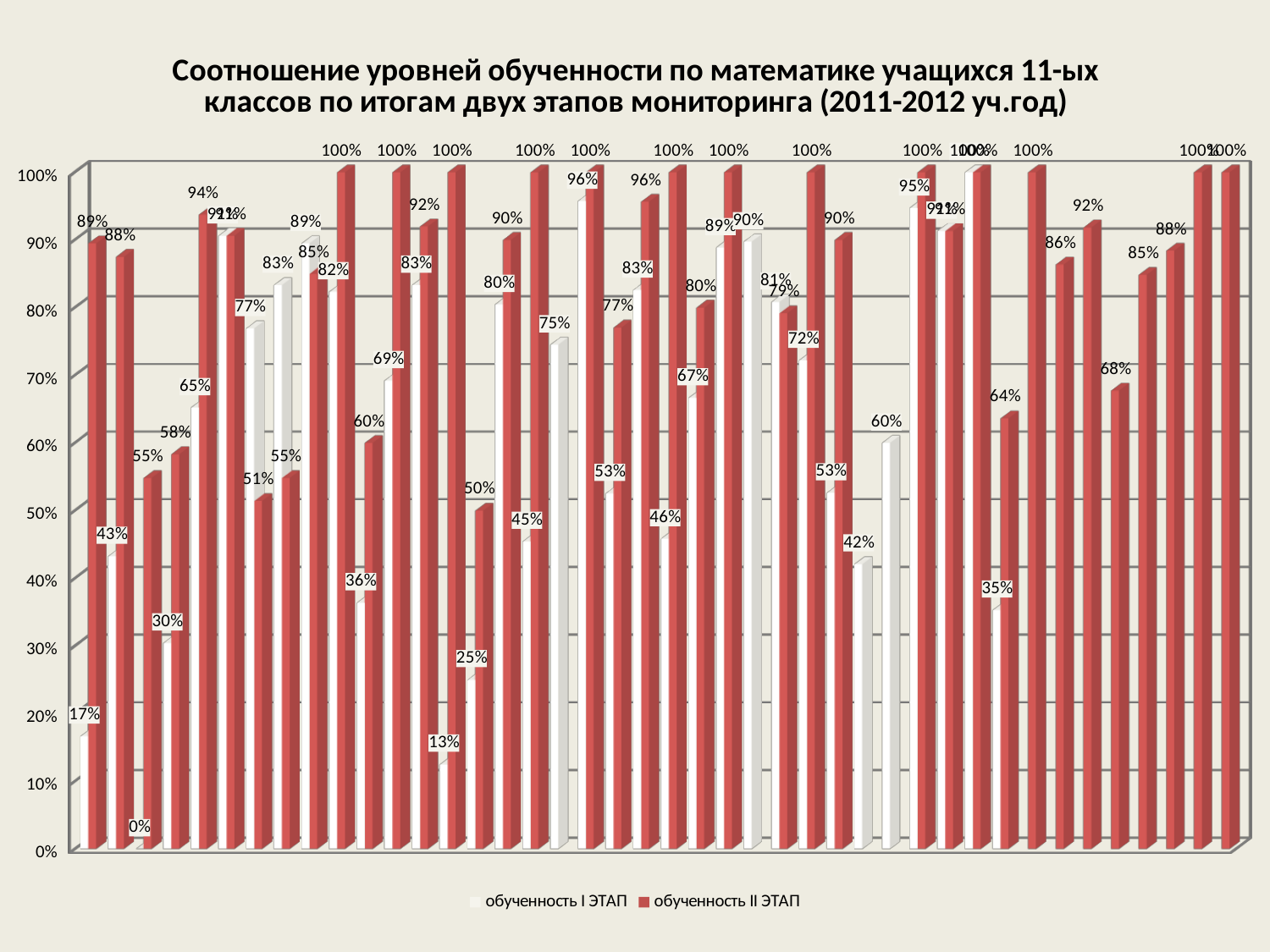
What is the lowest value labelled on the chart? 0% How many series does the legend list? 2 What kind of chart is shown on the slide? bar chart Is the value of the leftmost white bar greater or less than 20%? less In the leftmost pair of bars, which series has the larger value? обученность II ЭТАП What is the difference between the leftmost red bar (89%) and the leftmost white bar (17%)? 72 percentage points What are the two series named in the legend? обученность I ЭТАП and обученность II ЭТАП What is the value of the leftmost red (обученность II ЭТАП) bar? 89% What is the highest value labelled on the chart? 100% Which series is drawn in red? обученность II ЭТАП What is the value of the leftmost white (обученность I ЭТАП) bar? 17% What is the value of the rightmost red (обученность II ЭТАП) bar? 100%